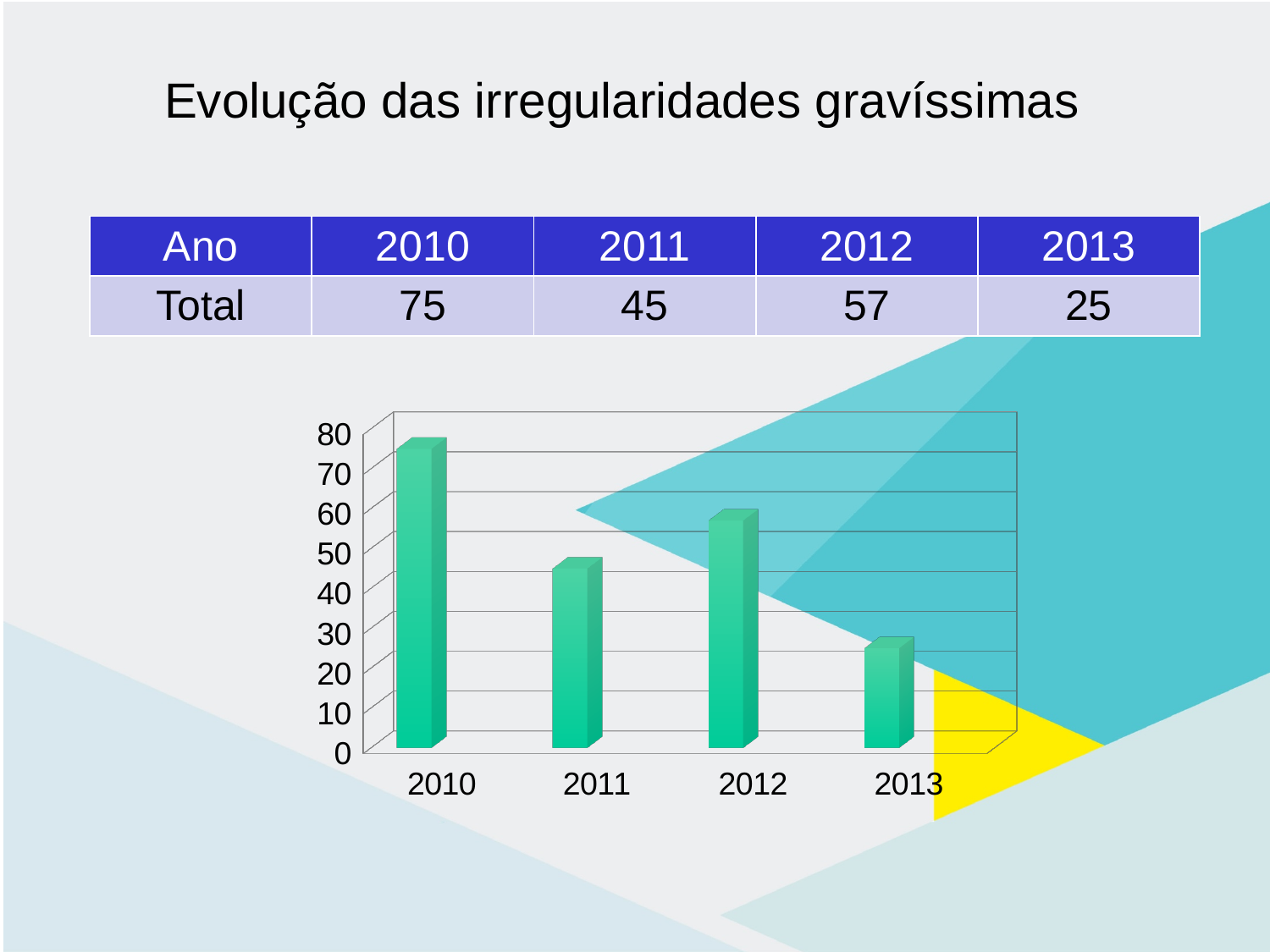
What is the value for 2012 in the chart? 57 What is the title of the slide? Evolução das irregularidades gravíssimas Which year has the highest value in the chart? 2010 Is the value for 2011 greater or less than 50? less Which year has the lowest value in the chart? 2013 What is the difference between the values for 2010 and 2013? 50 What is the value for 2010 in the chart? 75 What is the value for 2013 in the chart? 25 How many years are shown on the x axis of the chart? 4 What is the difference between the values for 2012 and 2011? 12 What kind of chart is shown on the slide? bar chart Which is larger, the value for 2011 or the value for 2012? 2012